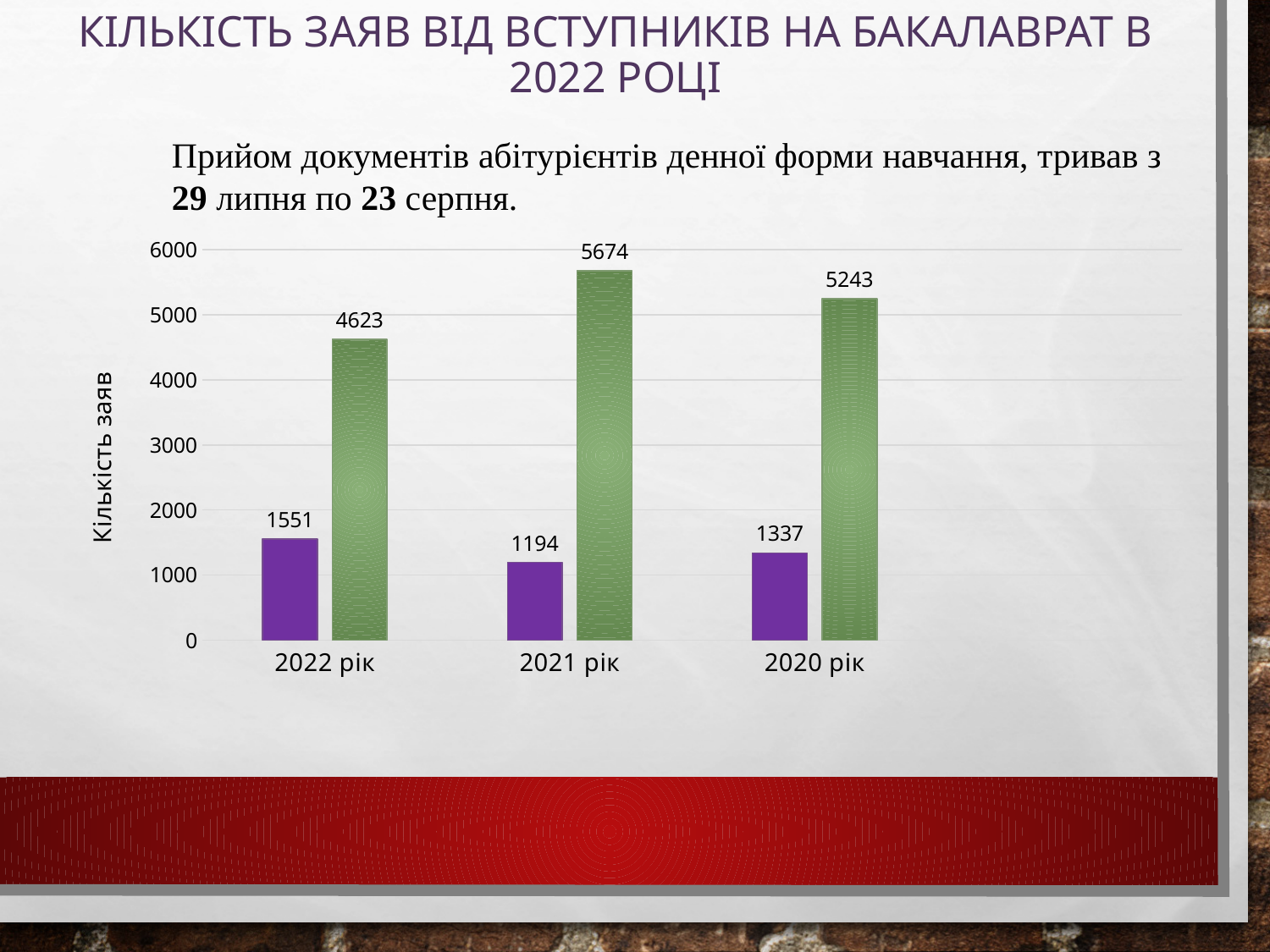
What kind of chart is shown on the slide? bar chart What is the value of the purple bar for 2022 рік? 1551 What is the value of the green bar for 2020 рік? 5243 What is the label of the vertical axis? Кількість заяв What is the value of the green bar for 2021 рік? 5674 What is the difference between the green bars for 2021 рік and 2020 рік? 431 Which category has the lowest purple bar? 2021 рік What is the value of the purple bar for 2021 рік? 1194 How many categories are shown on the x axis? 3 Which is larger: the purple bar for 2022 рік or the purple bar for 2020 рік? 2022 рік What is the difference between the green and purple bars for 2022 рік? 3072 Which category has the highest green bar? 2021 рік